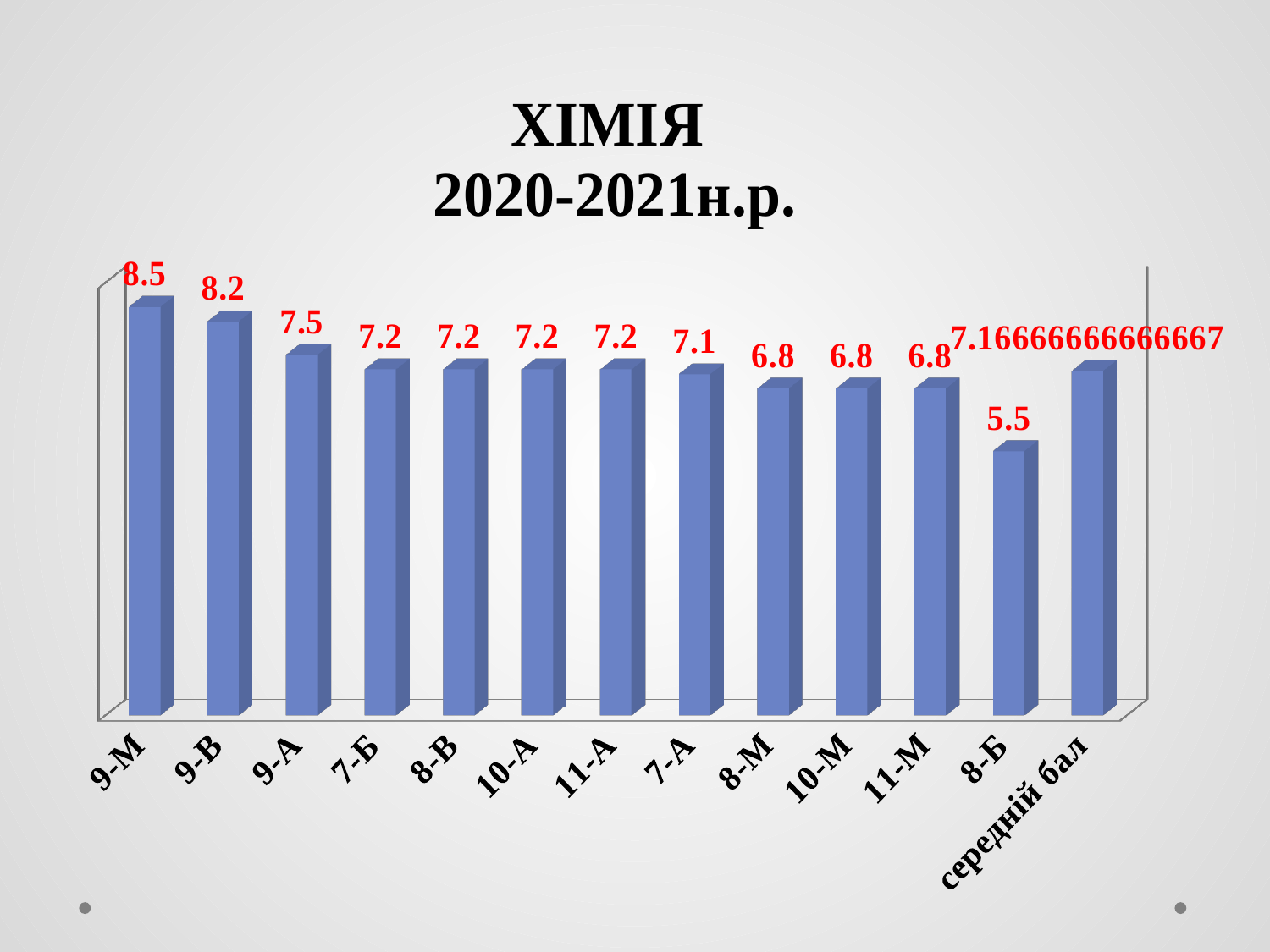
What is the difference between the values for 9-В and 9-А? 0.7 What is the value for 9-М? 8.5 Which category has the highest value? 9-М What value is shown for середній бал? 7.16666666666667 Which is larger, the value for 9-А or the value for 10-М? 9-А What is the value for 8-Б? 5.5 Which category has the lowest value? 8-Б What is the difference between the values for 9-М and 8-Б? 3 What kind of chart is shown on the slide? bar chart How many categories are shown on the x axis? 13 What is the title of the chart? ХІМІЯ 2020-2021н.р. What is the value for 7-А? 7.1